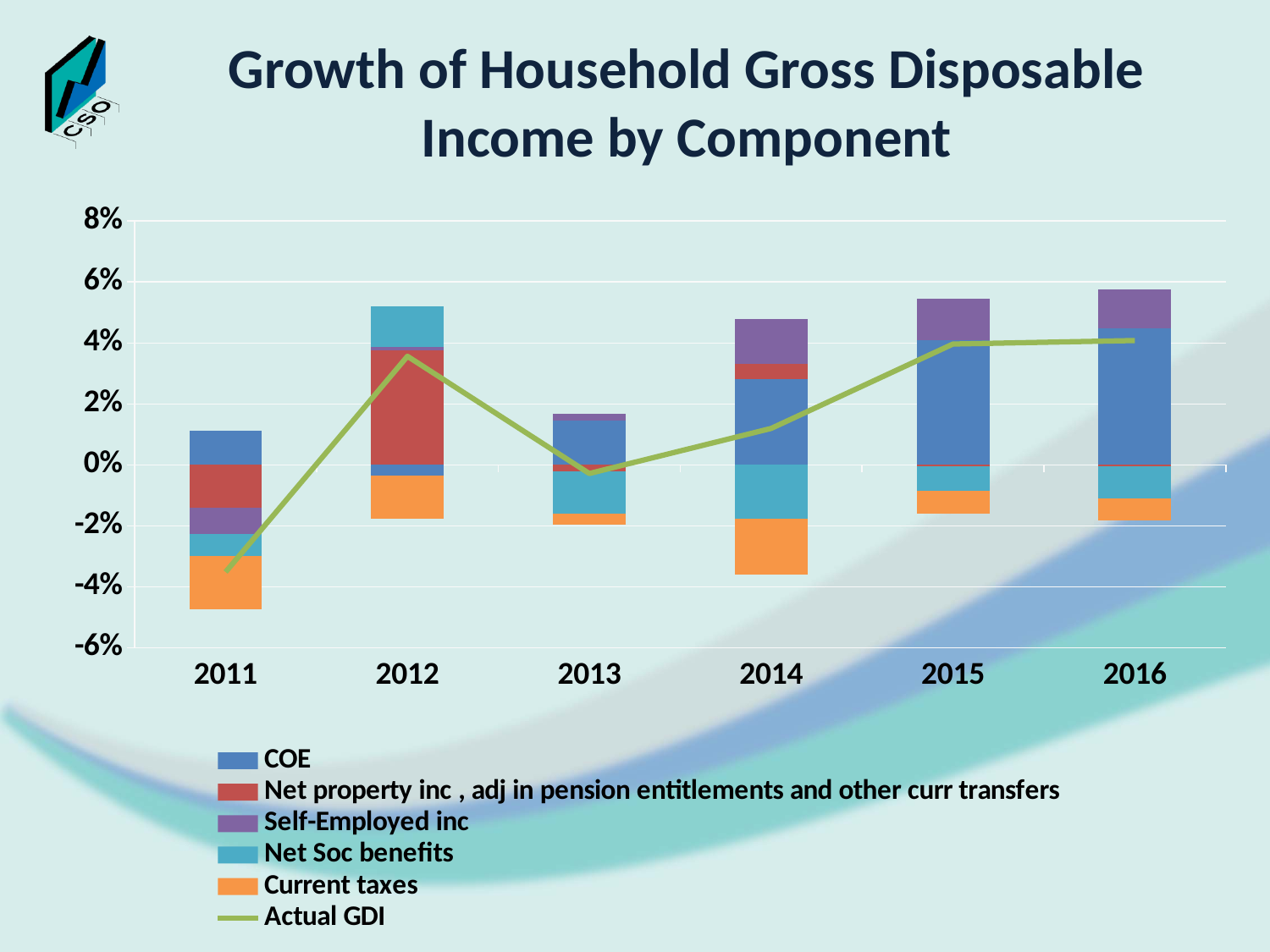
Is the Actual GDI value for 2012 greater or less than 2%? greater Is the Actual GDI value for 2015 greater or less than 2%? greater What is the title of the chart? Growth of Household Gross Disposable Income by Component In which year is the Actual GDI line at its lowest? 2011 From 2013 to 2016, does the Actual GDI line rise or fall? rise Is the Actual GDI value for 2014 greater or less than 2%? less Which series is plotted as a line rather than as bars? Actual GDI How many years are shown on the x axis of the chart? 6 Which year has the larger Actual GDI value, 2012 or 2014? 2012 How many series does the legend list? 6 What kind of chart is shown on the slide? A stacked bar chart with a line